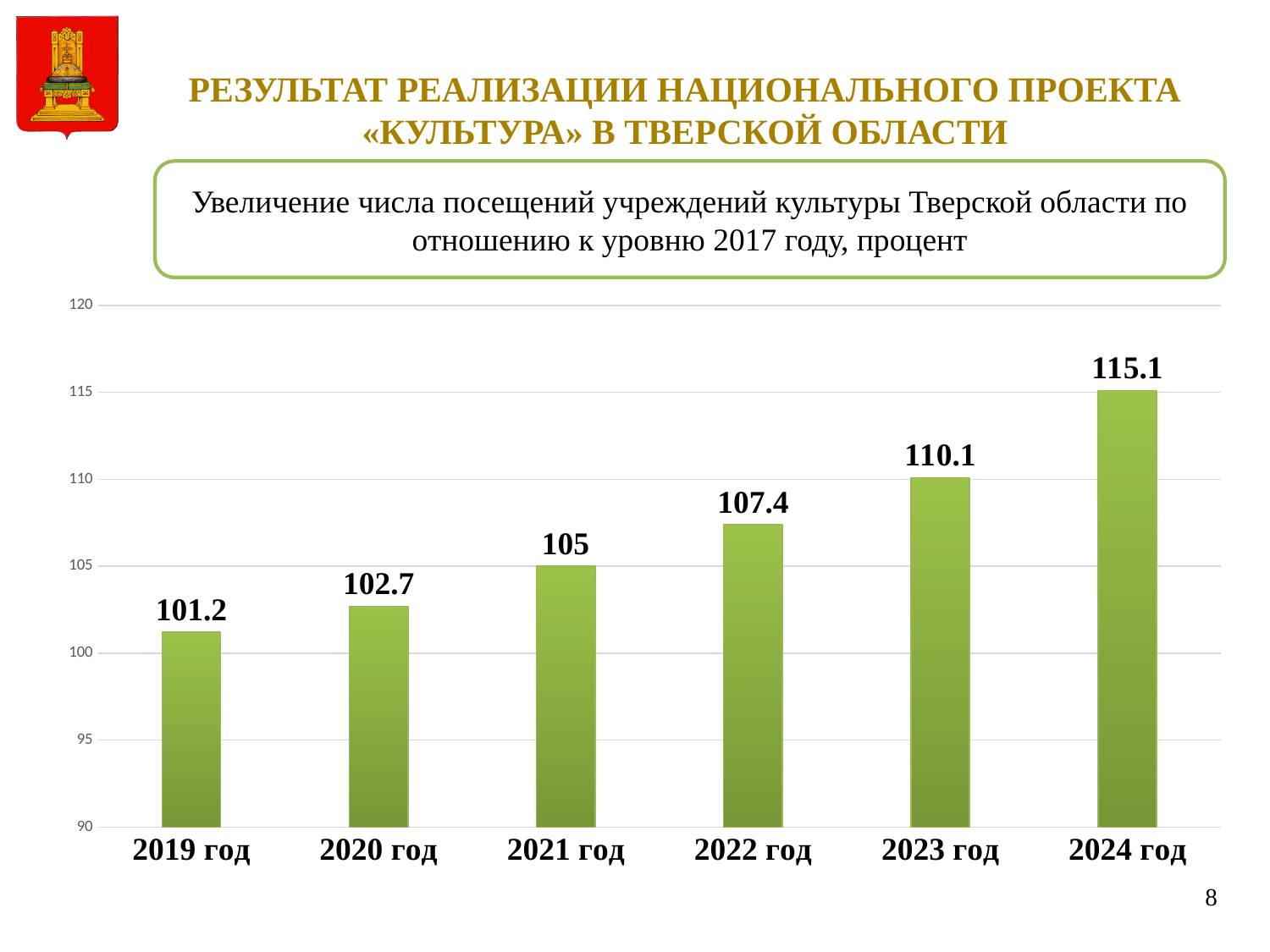
Is the value for 2023 год greater or less than 110? greater What is the difference between the values for 2022 год and 2020 год? 4.7 Do the values rise or fall from 2019 год to 2024 год? rise Which year has the lowest value? 2019 год What is the value for 2023 год? 110.1 What is the value for 2019 год? 101.2 What kind of chart is shown on the slide? bar chart What is the difference between the values for 2024 год and 2019 год? 13.9 Which is larger, the value for 2022 год or the value for 2021 год? 2022 год How many years are shown on the x axis? 6 What is the value for 2021 год? 105 Which year has the highest value? 2024 год